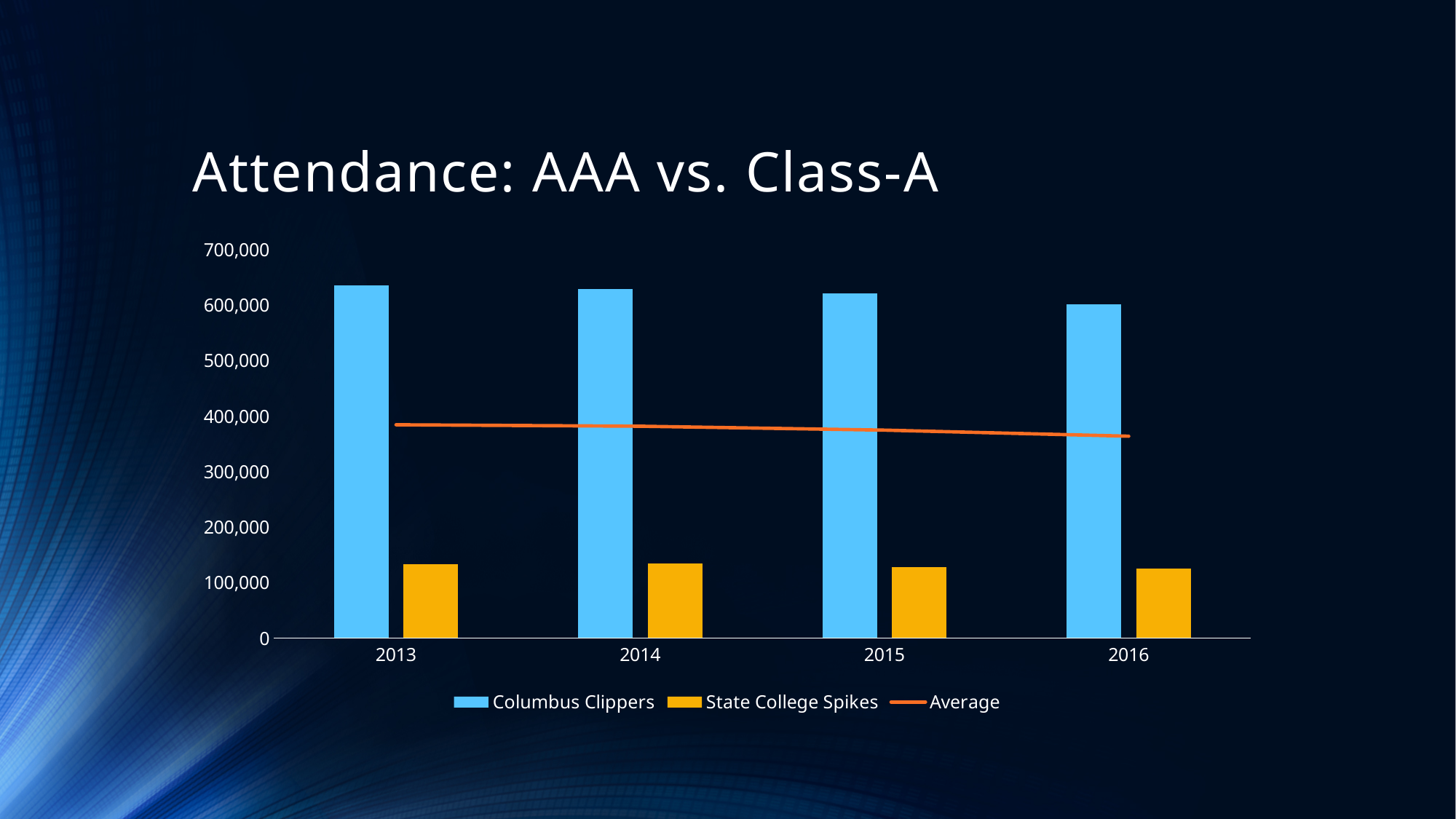
Do the Columbus Clippers values rise or fall from 2013 to 2016? fall What kind of chart is shown on the slide? bar chart with a line How many years are shown on the x axis? 4 Does the Average line rise or fall from 2013 to 2016? fall Is the State College Spikes value for 2014 greater or less than 200,000? less Is the Columbus Clippers value for 2013 greater or less than 600,000? greater In which year is the Columbus Clippers attendance lowest? 2016 Which is larger in 2015, the Columbus Clippers attendance or the State College Spikes attendance? Columbus Clippers How many series does the legend list? 3 Is the Average line value for 2016 greater or less than 400,000? less What is the title of the slide? Attendance: AAA vs. Class-A Which series is shown in orange bars? State College Spikes